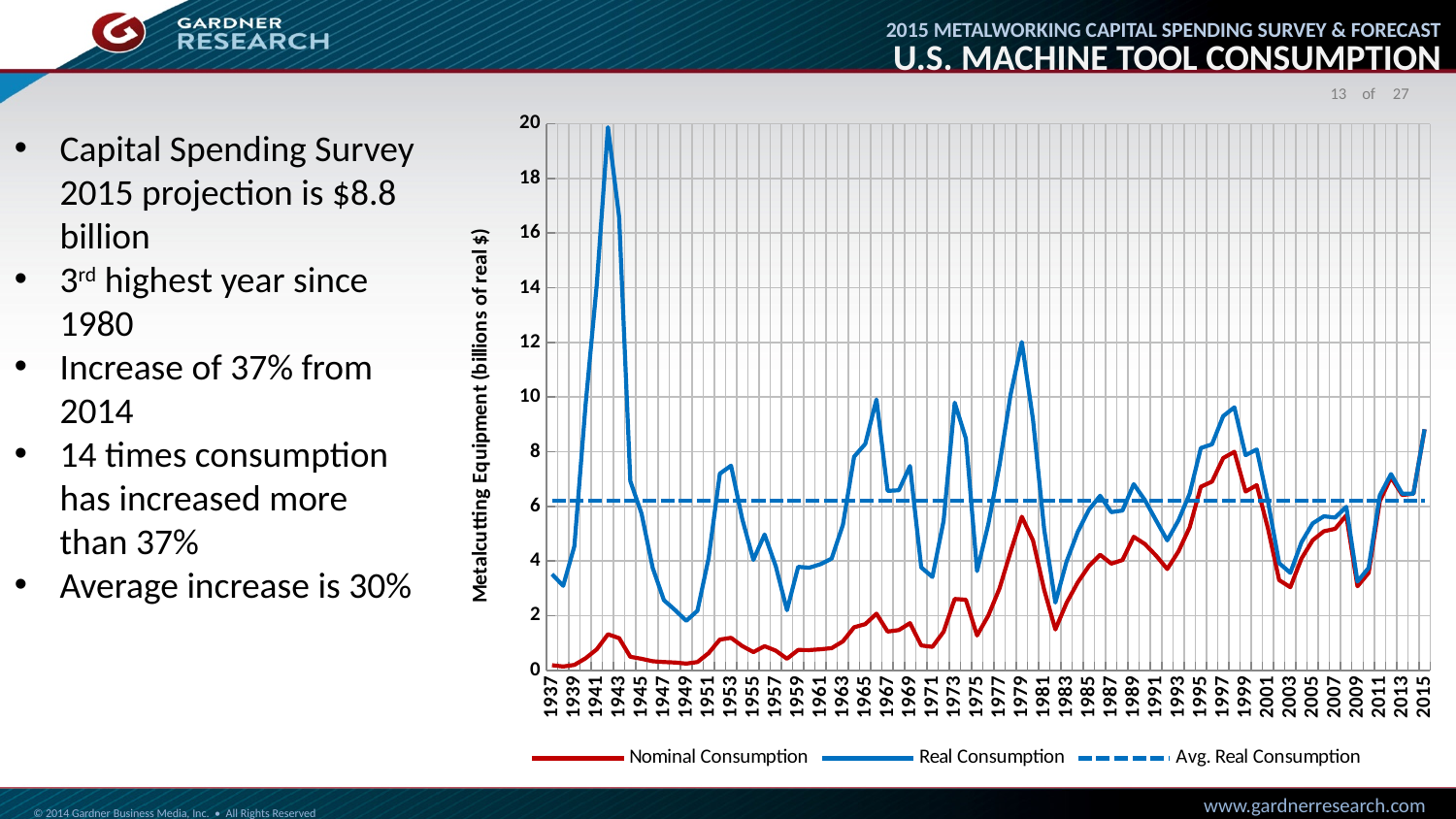
What are the three series named in the chart legend? Nominal Consumption, Real Consumption, Avg. Real Consumption What kind of chart is shown on the slide? line chart Is the Nominal Consumption value for 1979 greater or less than 4? greater Is the Nominal Consumption value for 1983 greater or less than 2? greater Is the Real Consumption value for 1943 greater or less than 18? less In 1965, which series has the higher value, Nominal Consumption or Real Consumption? Real Consumption What is the label on the chart's vertical axis? Metalcutting Equipment (billions of real $) How many series does the chart legend list? 3 Which is larger, Real Consumption in 1943 or Real Consumption in 1979? 1943 Does Real Consumption rise or fall between 1937 and 1943? rise